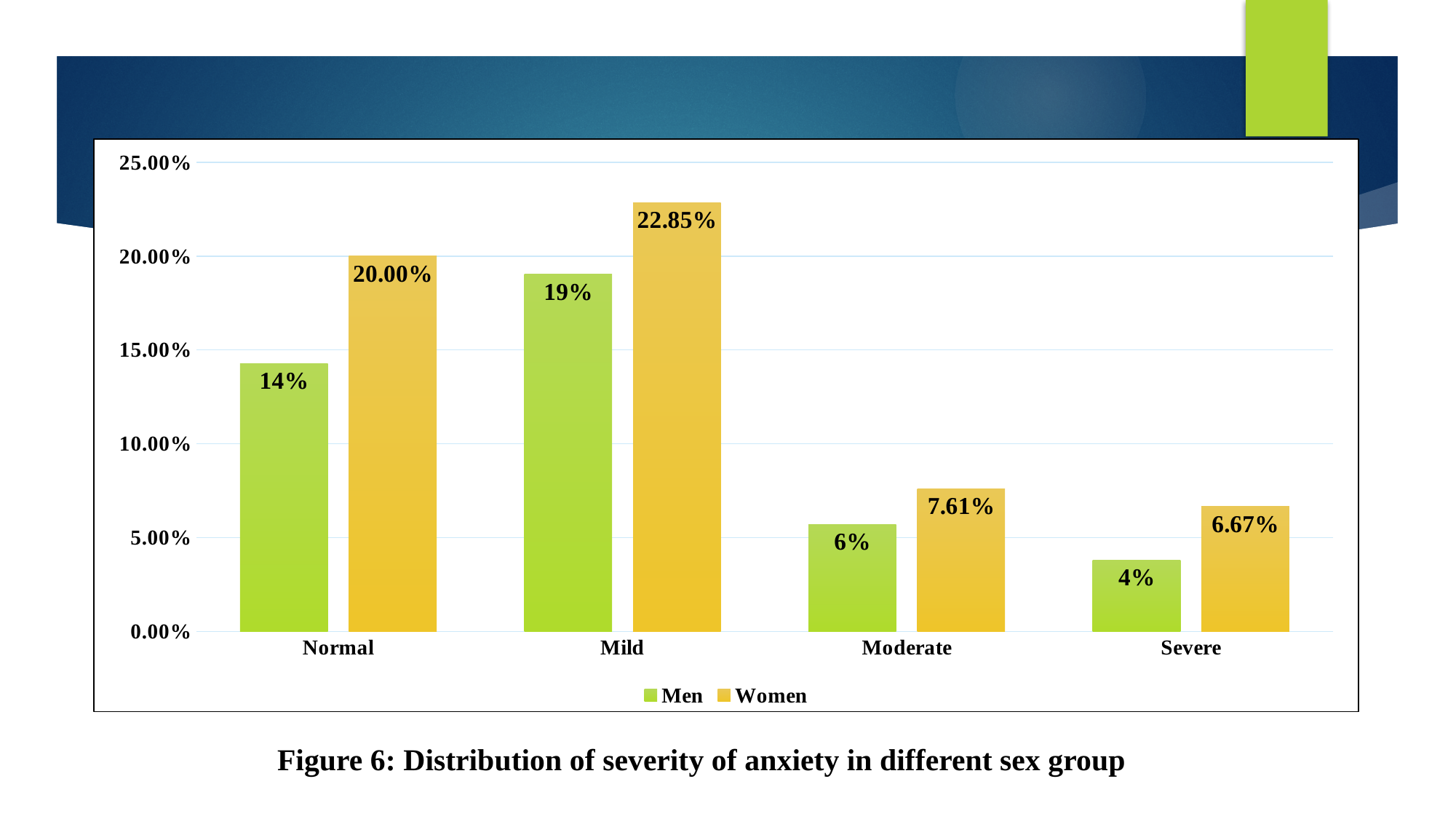
What is the value for Women in the Severe category? 6.67% What type of chart is shown on the slide? bar chart What is the value for Men in the Normal category? 14% How many categories are shown on the x axis? 4 What is the value for Men in the Moderate category? 6% What is the difference between the Women values for Mild and Normal? 2.85% What is the value for Women in the Mild category? 22.85% Which is larger in the Moderate category, the value for Men or for Women? Women Which category has the highest value for Women? Mild Which category has the lowest value for Men? Severe How many series does the legend list? 2 What is the figure caption below the chart? Figure 6: Distribution of severity of anxiety in different sex group